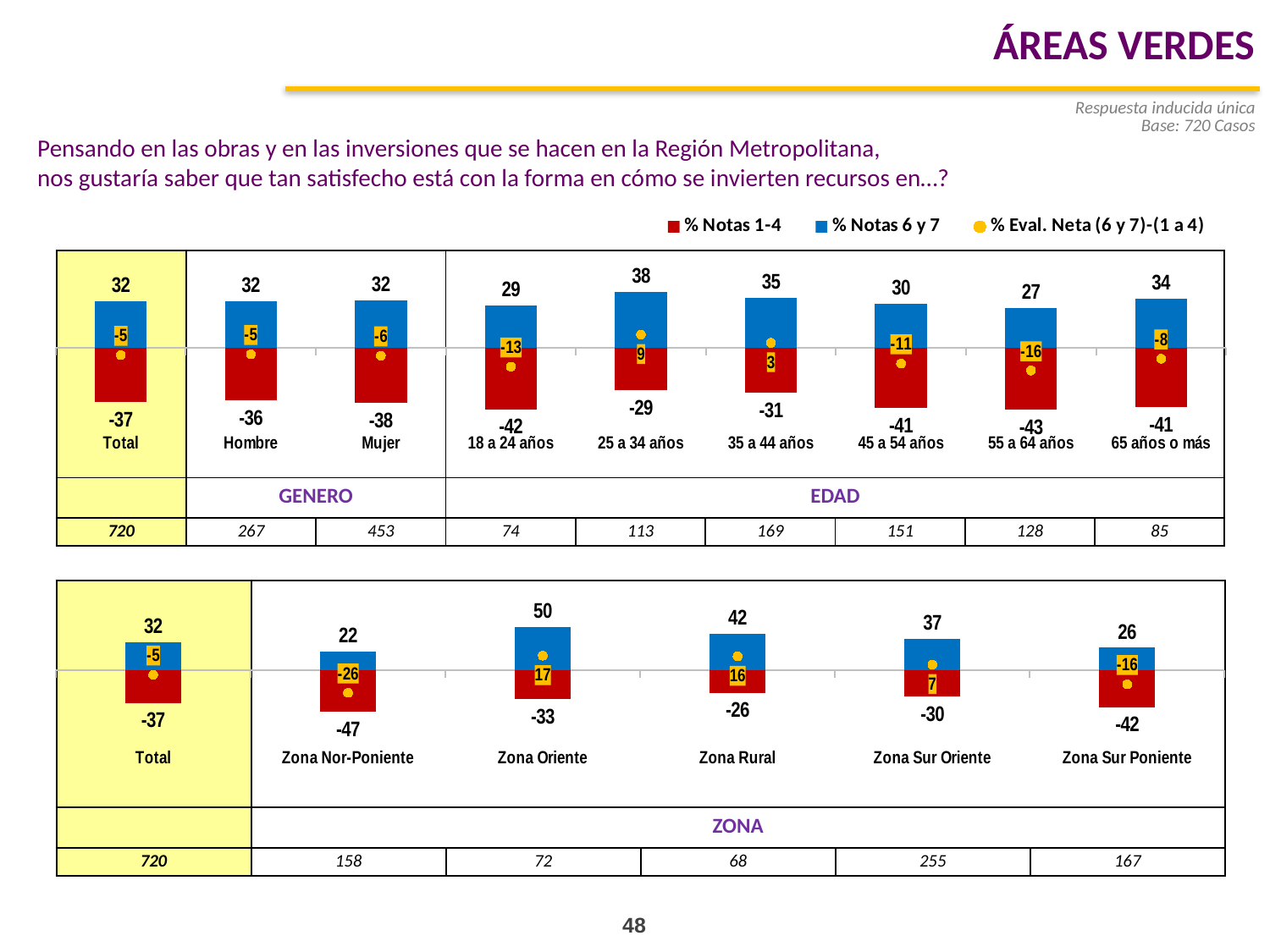
In the top chart, what is the % Notas 1-4 value for Mujer? -38 In the top chart, which age group has the highest % Notas 6 y 7 value? 25 a 34 años How many series does the legend list? 3 In the bottom chart, which is larger in % Notas 6 y 7: Zona Rural or Zona Sur Oriente? Zona Rural In the bottom chart, which zone has the highest % Notas 6 y 7 value? Zona Oriente In the top chart, which age group has the lowest % Notas 6 y 7 value? 55 a 64 años In the top chart, what is the % Eval. Neta value for 55 a 64 años? -16 In the bottom chart, what is the % Notas 6 y 7 value for Zona Oriente? 50 In the top chart, what is the difference between the % Notas 6 y 7 values for 35 a 44 años and 45 a 54 años? 5 What kind of chart is the bottom chart? Bar chart In the top chart, what is the % Notas 6 y 7 value for 25 a 34 años? 38 In the bottom chart, what is the % Eval. Neta value for Zona Nor-Poniente? -26